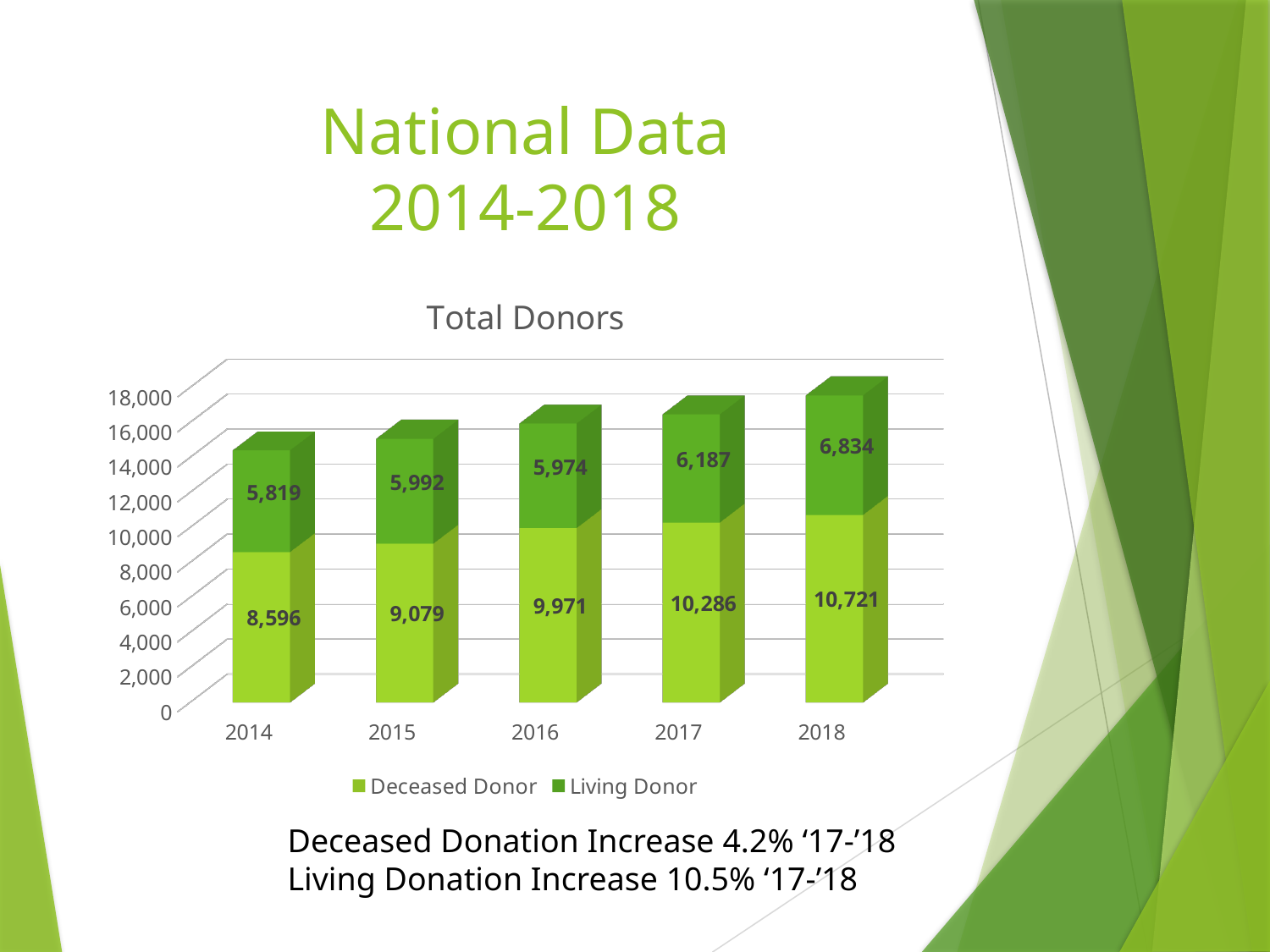
What is the Living Donor value for 2018? 6,834 How many years are shown on the x axis of the Total Donors chart? 5 What is the total of the stacked bar for 2014? 14,415 What is the Deceased Donor value for 2014? 8,596 Which year has the lowest Living Donor value? 2014 Which year has the highest Deceased Donor value? 2018 Do the Deceased Donor values rise or fall from 2014 to 2018? Rise How many series does the legend list in the Total Donors chart? 2 What is the title of the chart on the slide? Total Donors What type of chart is shown on the slide? Stacked bar chart What is the difference between the Deceased Donor values for 2018 and 2017? 435 What is the Deceased Donor value for 2016? 9,971